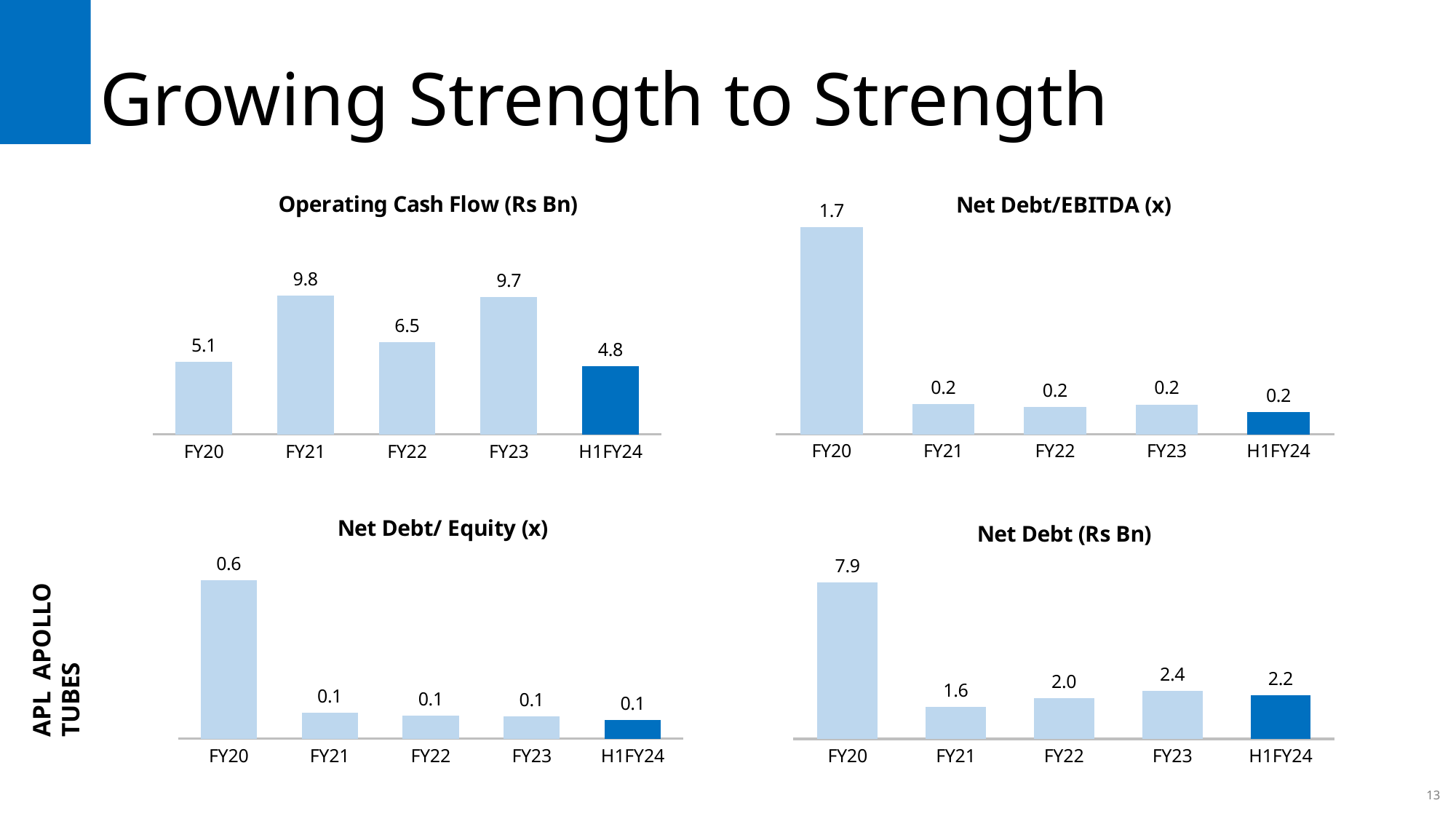
In the Net Debt (Rs Bn) chart, what is the difference between FY20 and FY21? 6.3 In the Net Debt (Rs Bn) chart, do the values rise or fall from FY21 to FY23? Rise In the Net Debt/ Equity (x) chart, which period has the highest value? FY20 In the Operating Cash Flow (Rs Bn) chart, what is the difference between FY21 and FY20? 4.7 In the Net Debt (Rs Bn) chart, which is larger, FY22 or H1FY24? H1FY24 In the Net Debt/ Equity (x) chart, what is the value for H1FY24? 0.1 In the Net Debt/EBITDA (x) chart, what is the value for FY20? 1.7 In the Net Debt (Rs Bn) chart, what is the value for FY23? 2.4 In the Operating Cash Flow (Rs Bn) chart, which period has the highest value? FY21 What type of chart is the Net Debt (Rs Bn) chart? Bar chart In the Net Debt/EBITDA (x) chart, how many periods are shown on the x axis? 5 In the Operating Cash Flow (Rs Bn) chart, what is the value for FY22? 6.5